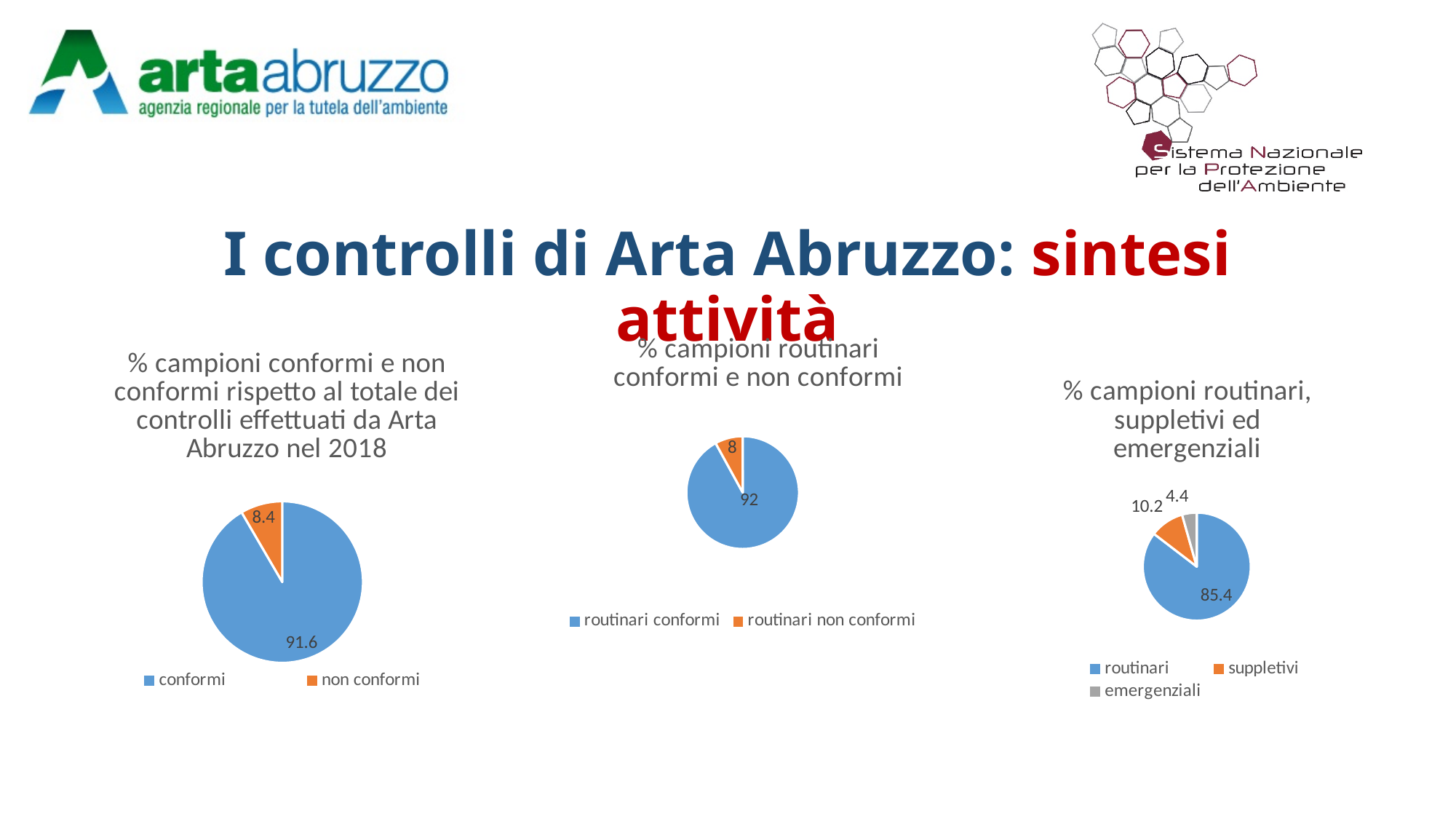
In the right chart (% campioni routinari, suppletivi ed emergenziali), what is the value for 'suppletivi'? 10.2 In the right chart, which category has the smallest slice? emergenziali In the left chart, what is the value for 'non conformi'? 8.4 In the middle chart, which slice is larger, 'routinari conformi' or 'routinari non conformi'? routinari conformi In the left chart (% campioni conformi e non conformi rispetto al totale dei controlli effettuati da Arta Abruzzo nel 2018), what is the value for 'conformi'? 91.6 What kind of chart is the left chart? Pie chart In the left chart, what is the difference between the 'conformi' and 'non conformi' values? 83.2 How many categories does the legend of the right chart list? 3 In the right chart, what is the value for 'emergenziali'? 4.4 In the right chart, what is the difference between the 'suppletivi' and 'emergenziali' values? 5.8 In the middle chart (% campioni routinari conformi e non conformi), what is the value for 'routinari conformi'? 92 In the middle chart, what is the value for 'routinari non conformi'? 8